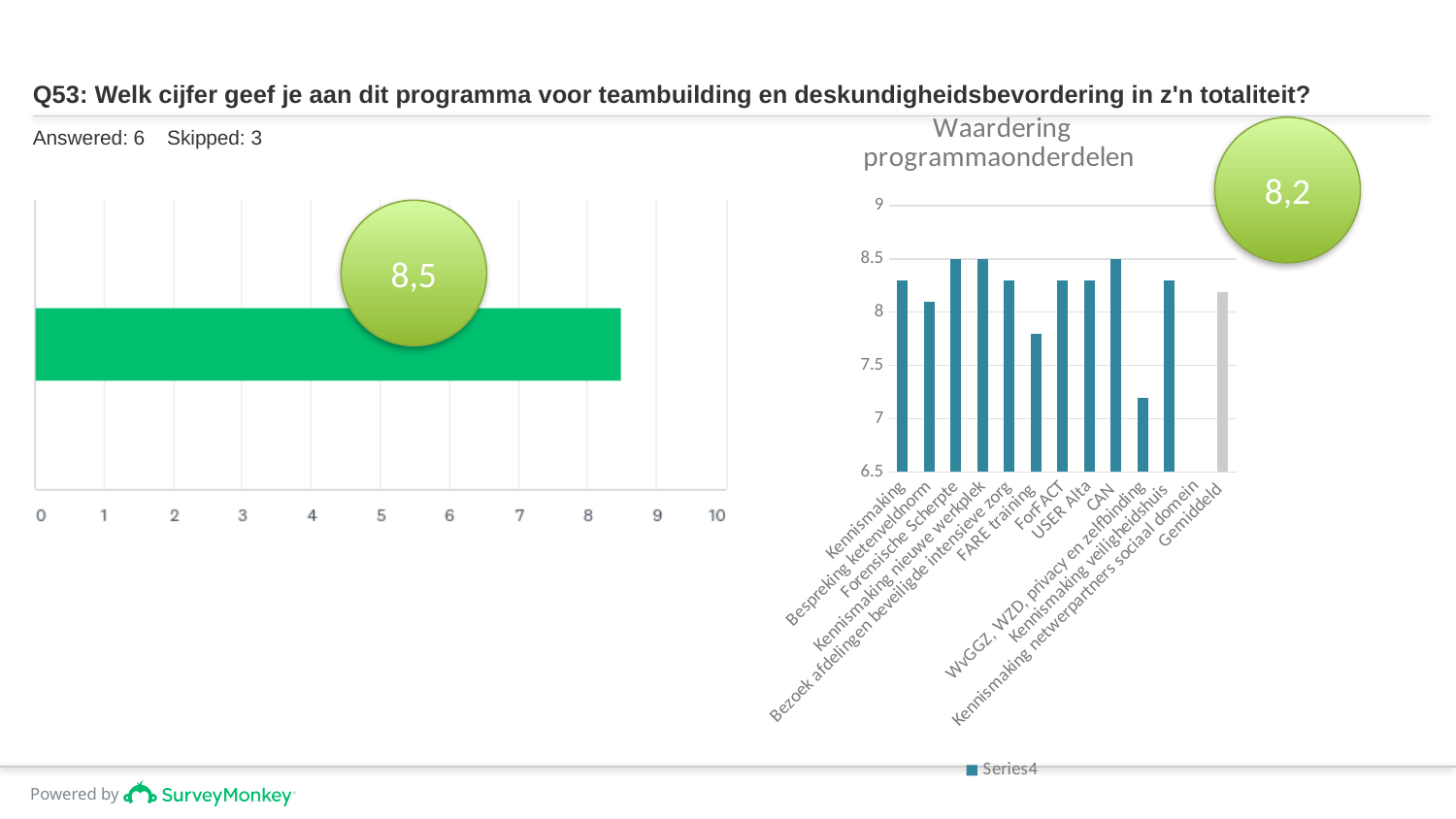
How many categories are shown on the x axis of the 'Waardering programmaonderdelen' chart? 13 In the 'Waardering programmaonderdelen' chart, is the value for Forensische Scherpte greater or less than 8? greater What kind of chart is the chart on the left under Q53? bar chart In the 'Waardering programmaonderdelen' chart, is the value for WvGGZ, WZD, privacy en zelfbinding greater or less than 7.5? less What is the name of the series listed in the legend of the 'Waardering programmaonderdelen' chart? Series4 What kind of chart is the 'Waardering programmaonderdelen' chart on the right? bar chart In the 'Waardering programmaonderdelen' chart, which is larger: the value for CAN or the value for FARE training? CAN In the 'Waardering programmaonderdelen' chart, which category has the lowest value? WvGGZ, WZD, privacy en zelfbinding In the 'Waardering programmaonderdelen' chart, which is larger: the value for FARE training or the value for WvGGZ, WZD, privacy en zelfbinding? FARE training In the 'Waardering programmaonderdelen' chart, is the value for FARE training greater or less than 8? less How many series does the legend of the 'Waardering programmaonderdelen' chart list? 1